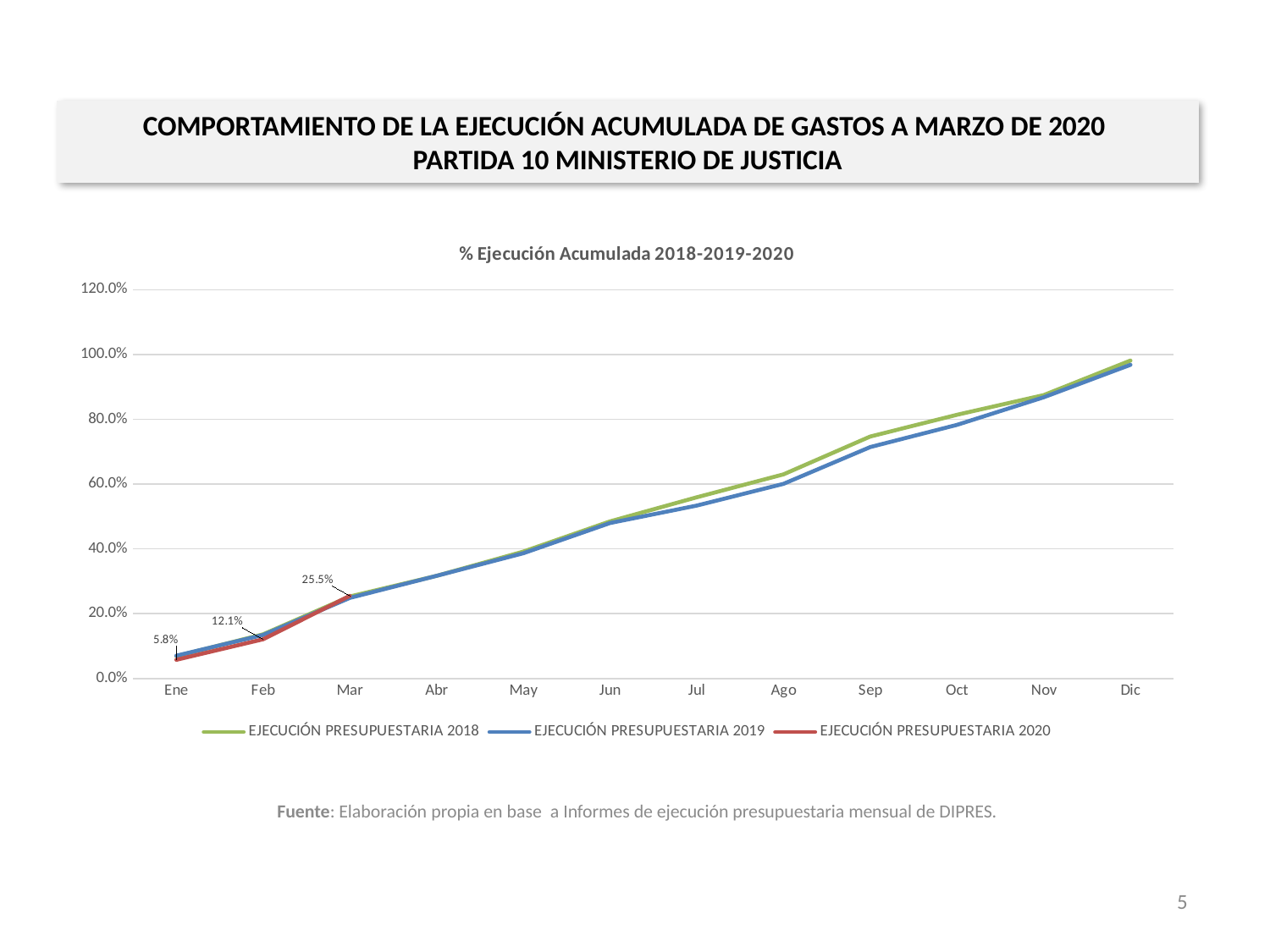
What is the value for EJECUCIÓN PRESUPUESTARIA 2020 in Mar? 25.5% What kind of chart is shown? Line chart Do the values for EJECUCIÓN PRESUPUESTARIA 2018 rise or fall from Ene to Dic? Rise In Sep, which series is higher: EJECUCIÓN PRESUPUESTARIA 2018 or EJECUCIÓN PRESUPUESTARIA 2019? EJECUCIÓN PRESUPUESTARIA 2018 How many months are shown on the x axis? 12 By how much did EJECUCIÓN PRESUPUESTARIA 2020 increase from Feb to Mar? 13.4% What is the title of the chart? % Ejecución Acumulada 2018-2019-2020 Is the value for EJECUCIÓN PRESUPUESTARIA 2018 in Ago greater or less than 80.0%? less What is the value for EJECUCIÓN PRESUPUESTARIA 2020 in Ene? 5.8% Among the labelled months for EJECUCIÓN PRESUPUESTARIA 2020, which has the highest value? Mar What is the value for EJECUCIÓN PRESUPUESTARIA 2020 in Feb? 12.1% How many series does the legend list? 3